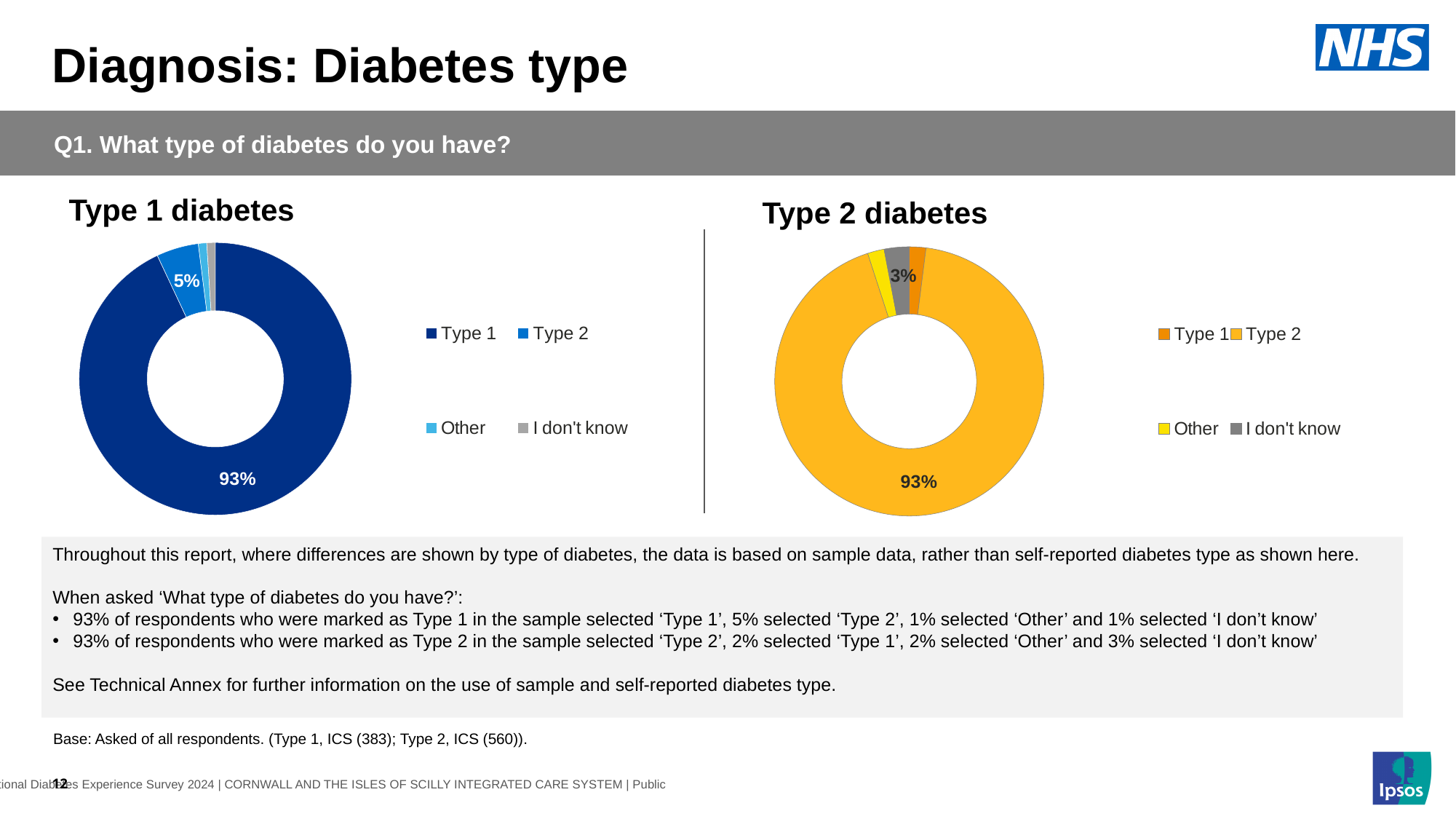
In the Type 1 diabetes chart, what percentage of respondents selected 'Type 1'? 93% How many categories does the legend of the Type 1 diabetes chart list? 4 In the Type 2 diabetes chart, what percentage of respondents selected 'Type 2'? 93% In the Type 1 diabetes chart, what is the difference in percentage points between the 'Type 1' slice and the 'Type 2' slice? 88 percentage points In the Type 1 diabetes chart, what percentage of respondents selected 'Type 2'? 5% In the Type 2 diabetes chart, which category has the largest slice? Type 2 In the Type 1 diabetes chart, what colour is the 'Type 1' slice? Dark blue In the Type 2 diabetes chart, which slice is larger: 'Type 2' or 'I don't know'? Type 2 In the Type 2 diabetes chart, what colour is the 'I don't know' slice? Grey In the Type 1 diabetes chart, which category has the largest slice? Type 1 What kind of chart is used for the Type 2 diabetes data? Doughnut (pie) chart In the Type 2 diabetes chart, what percentage of respondents selected 'I don't know'? 3%